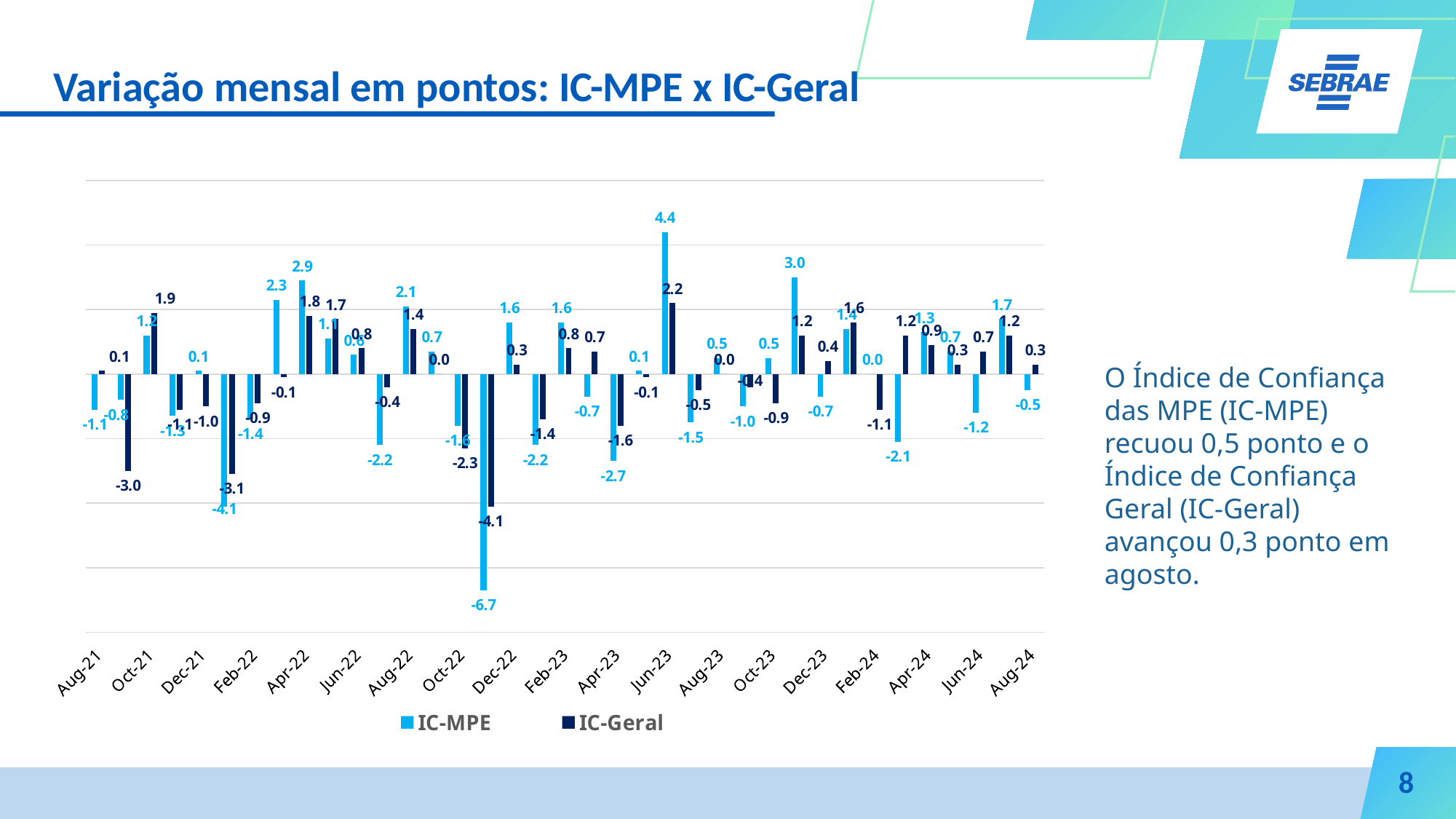
What is the IC-MPE value for Jun-23? 4.4 How many series does the legend list? 2 What is the IC-Geral value for Oct-21? 1.9 What is the IC-Geral value for Aug-24? 0.3 What are the two series named in the legend? IC-MPE and IC-Geral In Jun-23, what is the difference between the IC-MPE value and the IC-Geral value? 2.2 What is the IC-MPE value for Apr-23? -2.7 In Apr-22, which series has the larger value, IC-MPE or IC-Geral? IC-MPE Which month has the highest IC-MPE value? Jun-23 What kind of chart is shown on the slide? bar chart What is the lowest IC-MPE value shown in the chart? -6.7 What is the IC-MPE value for Aug-24? -0.5